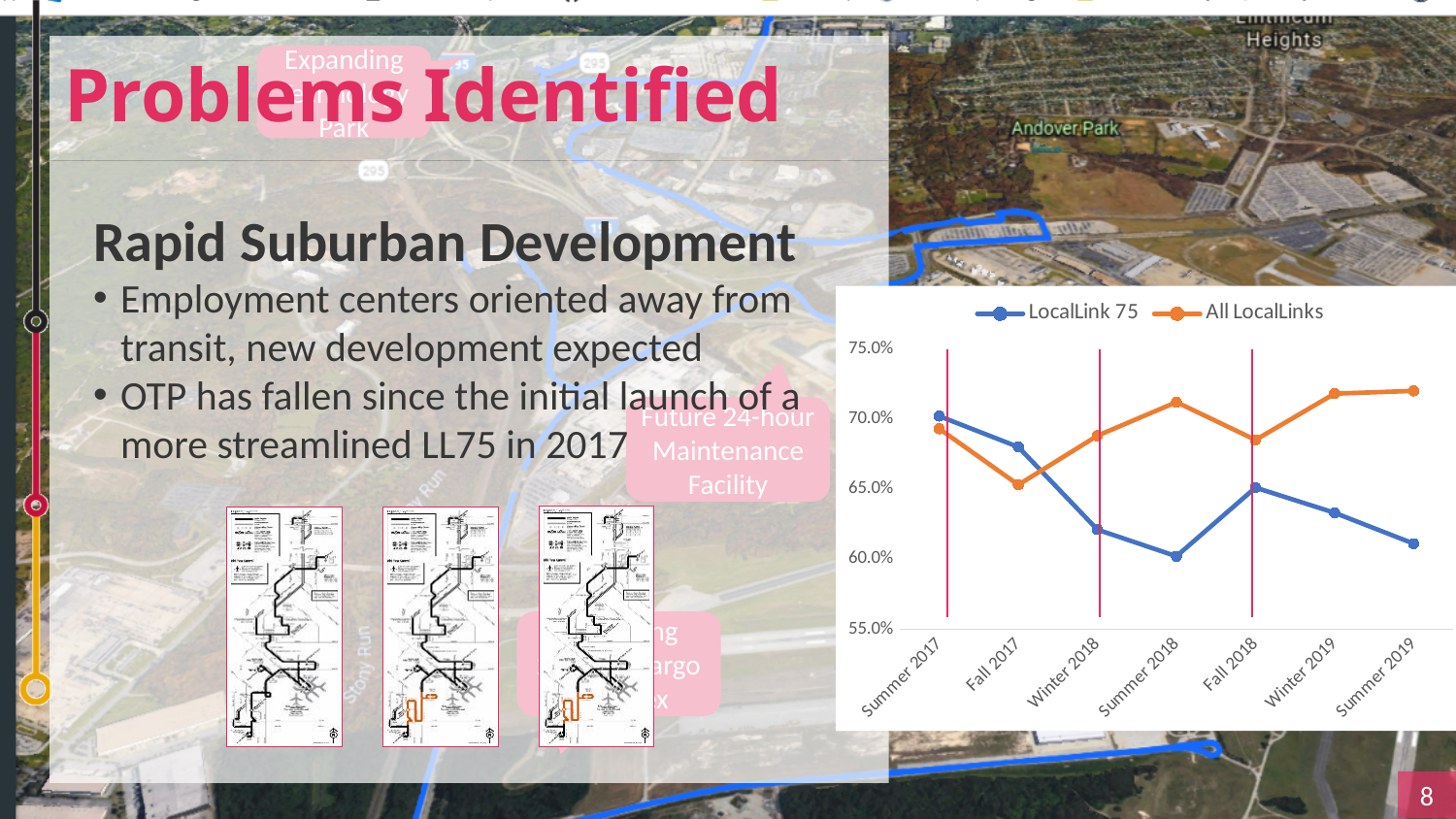
In which period is the LocalLink 75 value lowest? Summer 2018 In which period is the All LocalLinks value lowest? Fall 2017 Is the All LocalLinks value for Summer 2018 greater or less than 70.0%? greater Is the LocalLink 75 value for Summer 2018 greater or less than 65.0%? less What colour is the LocalLink 75 line in the chart? blue In Summer 2018, which series has the higher value, LocalLink 75 or All LocalLinks? All LocalLinks In which period is the LocalLink 75 value highest? Summer 2017 How many time periods are plotted along the x axis of the chart? 7 Does the LocalLink 75 line rise or fall from Summer 2017 to Summer 2018? fall How many series does the legend of the chart list? 2 What kind of chart is shown on the right side of the slide? line chart Is the All LocalLinks value for Fall 2017 greater or less than 70.0%? less